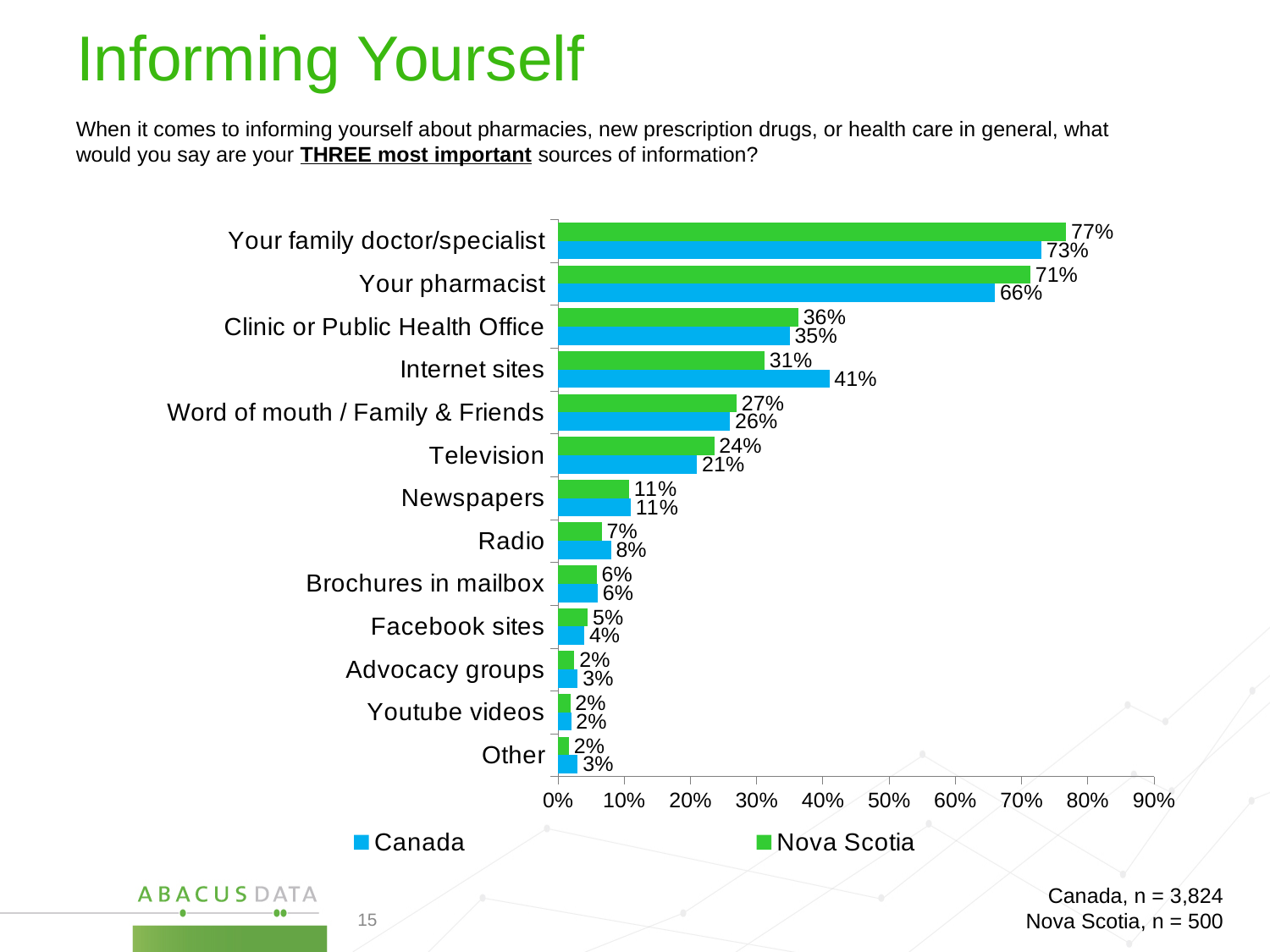
What is the difference between the Nova Scotia and Canada values for Internet sites? 10% Which colour represents Nova Scotia in the chart? Green Which source has the highest value for Canada? Your family doctor/specialist What type of chart is shown on the slide? Bar chart What percentage of Nova Scotia respondents cited their family doctor/specialist as a top source of information? 77% What is the difference between the Nova Scotia values for Your family doctor/specialist and Your pharmacist? 6% What is the Canada value for Internet sites? 41% For Television, which is larger: the Canada value or the Nova Scotia value? Nova Scotia What is the Canada value for Your pharmacist? 66% How many series does the legend list? 2 How many information sources (categories) are shown in the chart? 13 For Internet sites, which is larger: the Canada value or the Nova Scotia value? Canada